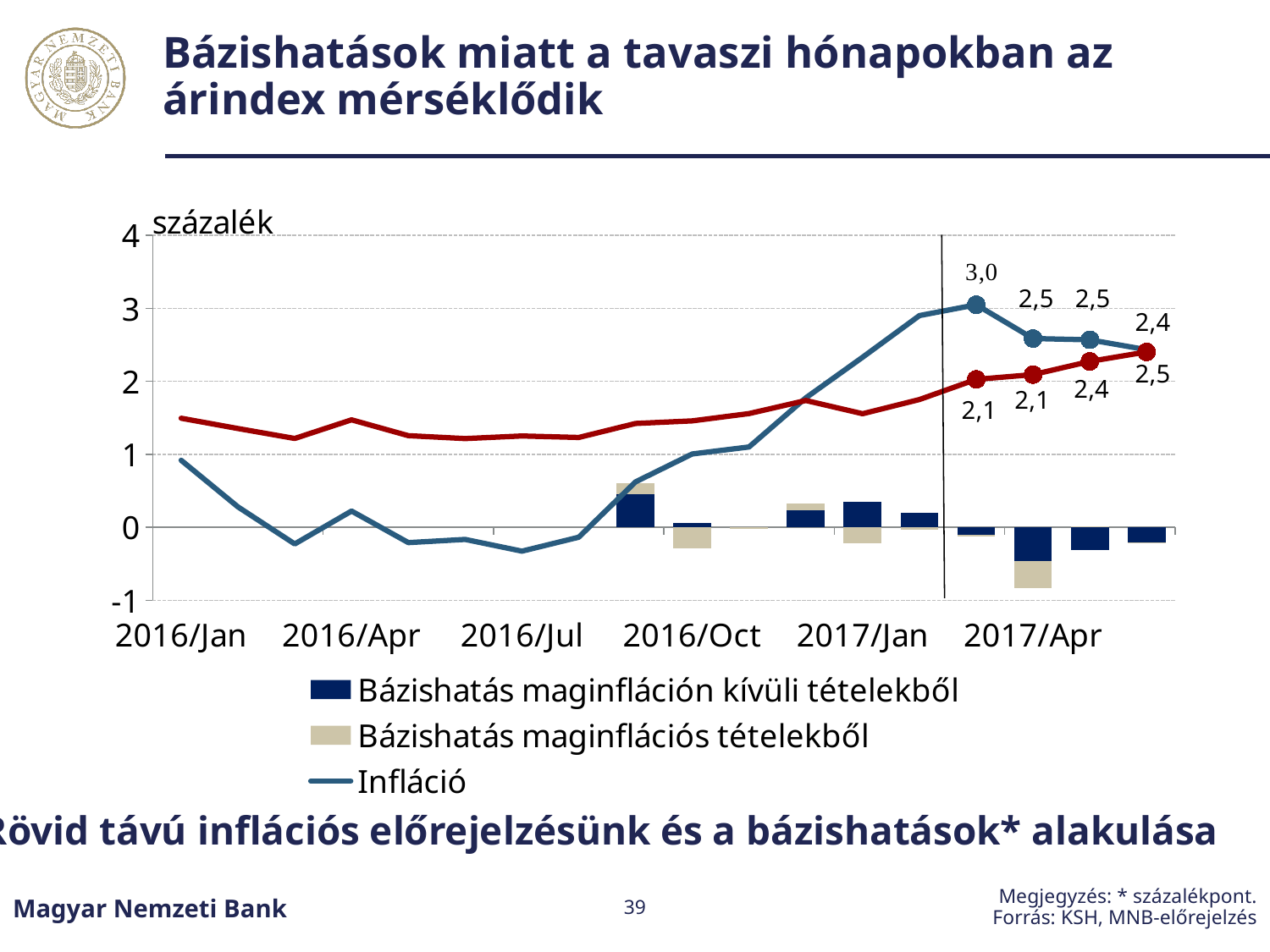
How many data labels are printed on the Infláció line? 4 At the rightmost labelled point, which is larger: the Infláció line value or the red line value? The red line (2,5 vs 2,4) Is the Infláció value at 2016/Apr greater or less than 1? less What is the difference between the first labelled Infláció value (3,0) and the first labelled red-line value (2,1)? 0,9 What is the last (rightmost) labelled value on the red line? 2,5 What unit label is shown at the top of the vertical axis? százalék What kind of chart is shown on the slide? A combination chart with stacked bars and lines Does the Infláció line rise or fall between 2016/Jul and 2017/Jan? rise What is the last (rightmost) labelled value on the Infláció line? 2,4 How many series does the legend list? 3 Is the Infláció value at 2017/Jan greater or less than 2? greater What is the highest labelled value on the Infláció line? 3,0